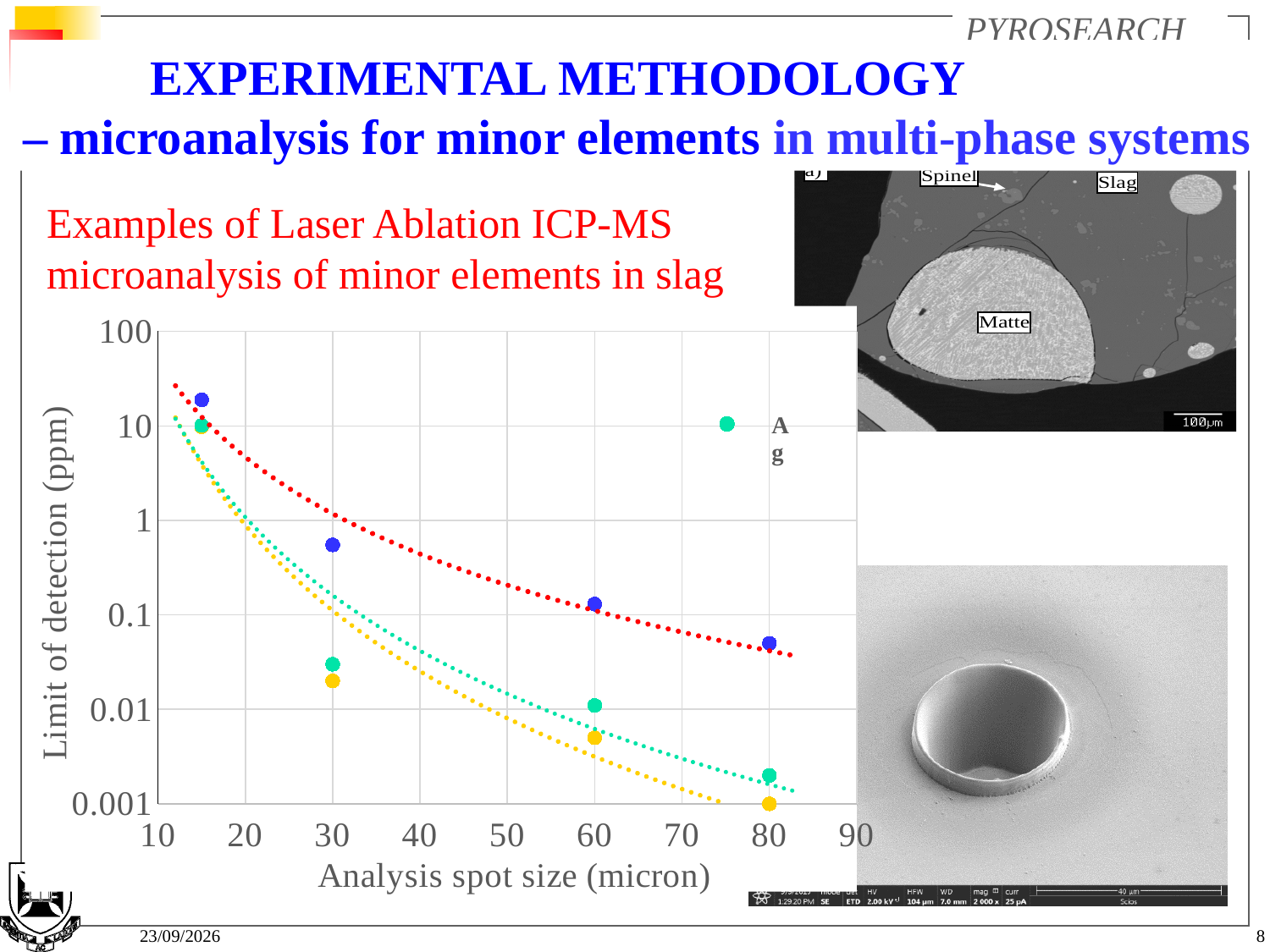
How many data points does the blue series have? 4 What is the label of the y axis of the chart? Limit of detection (ppm) Which series has the highest limit of detection at 80 micron? blue series Which series has the lowest limit of detection at 60 micron? yellow series Is the value of the blue series at 15 micron greater or less than 10 ppm? greater Is the value of the yellow series at 60 micron greater or less than 0.01 ppm? less What is the label of the x axis of the chart? Analysis spot size (micron) At 30 micron, which series has the larger limit of detection, the blue series or the yellow series? blue series Do the limit of detection values rise or fall as the analysis spot size increases? fall What kind of chart is shown on the slide? scatter chart Is the value of the blue series at 30 micron greater or less than 1 ppm? less